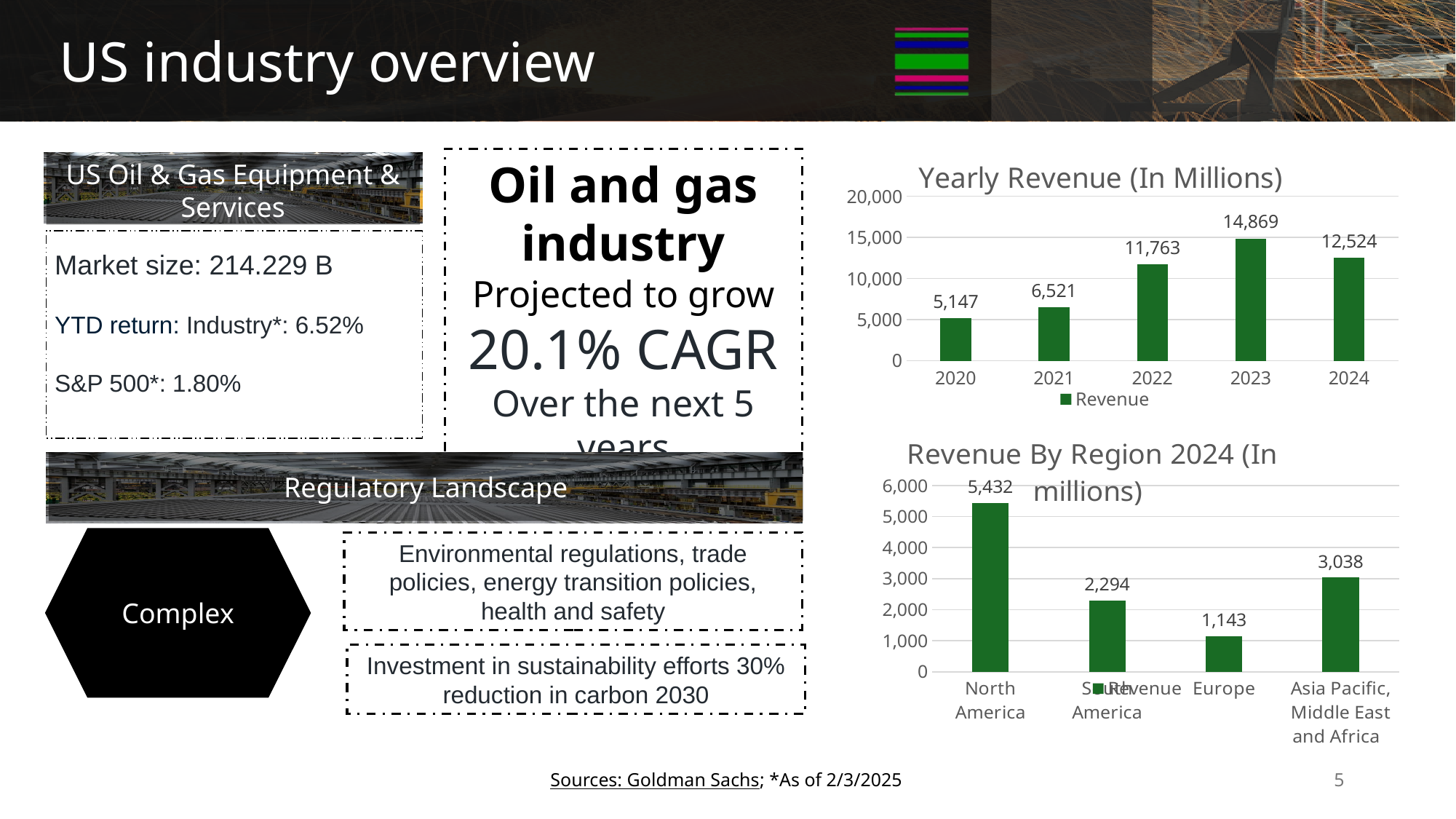
How many series does the legend of the 'Yearly Revenue (In Millions)' chart list? 1 In the 'Revenue By Region 2024 (In millions)' chart, which region has the highest revenue? North America In the 'Revenue By Region 2024 (In millions)' chart, what is the difference between North America and South America? 3,138 In the 'Yearly Revenue (In Millions)' chart, how many years are shown on the x axis? 5 In the 'Yearly Revenue (In Millions)' chart, which year has the highest revenue? 2023 What kind of chart is the 'Yearly Revenue (In Millions)' chart? bar chart In the 'Revenue By Region 2024 (In millions)' chart, what is the revenue for Europe? 1,143 In the 'Yearly Revenue (In Millions)' chart, which year has the lowest revenue? 2020 In the 'Yearly Revenue (In Millions)' chart, does revenue rise or fall from 2020 to 2023? rise In the 'Yearly Revenue (In Millions)' chart, what is the revenue for 2022? 11,763 In the 'Revenue By Region 2024 (In millions)' chart, which is larger: South America or Asia Pacific, Middle East and Africa? Asia Pacific, Middle East and Africa In the 'Yearly Revenue (In Millions)' chart, what is the difference between the 2023 and 2024 revenue values? 2,345